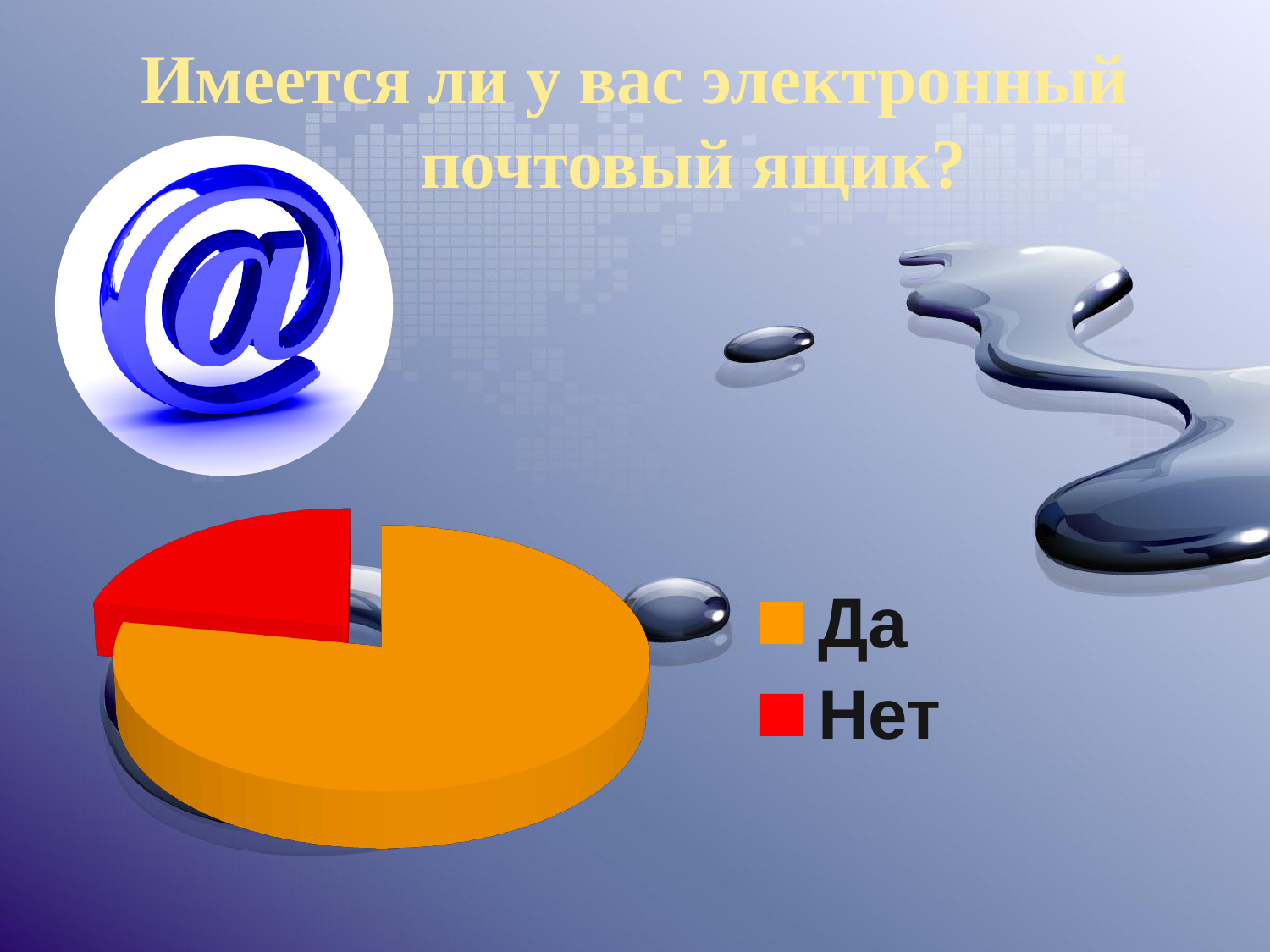
What is the title of the slide containing the pie chart? Имеется ли у вас электронный почтовый ящик? How many entries does the legend of the pie chart list? 2 What colour is the Да slice in the pie chart? orange Which slice of the pie chart is the largest? Да How many slices does the pie chart have? 2 Which slice of the pie chart is the smallest? Нет Which slice is larger in the pie chart, Да or Нет? Да What kind of chart is shown on the slide? pie chart